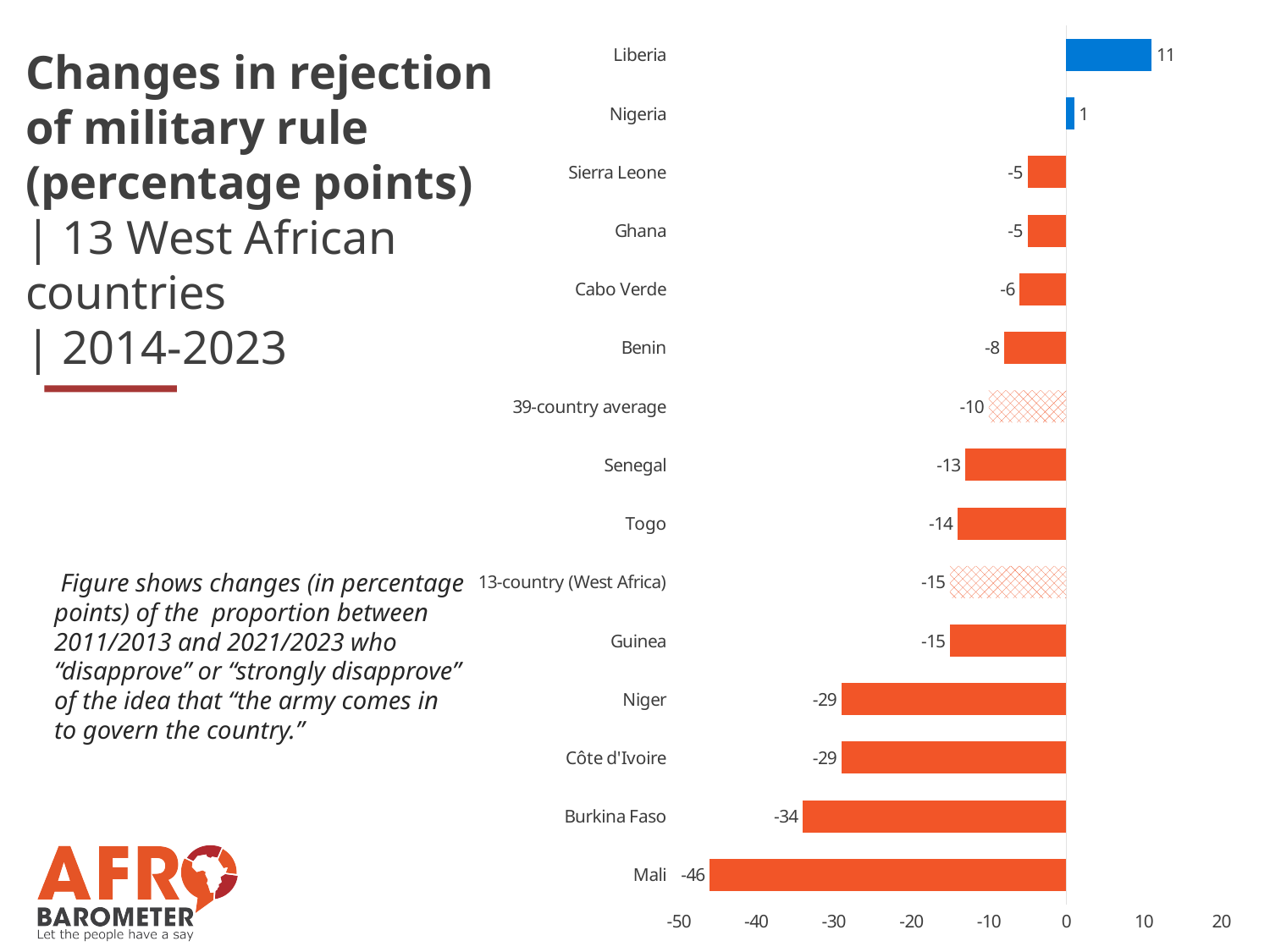
Is the value for Niger greater or less than -20? less Which country has the lowest value? Mali What is the value for the 13-country (West Africa) average? -15 What is the value for the 39-country average? -10 What is the difference between the values for Burkina Faso and Mali? 12 How many bars are plotted in the chart? 15 Which country has the highest value? Liberia Which has a larger value, Senegal or Togo? Senegal What is the value for Mali? -46 What kind of chart is shown on the slide? Bar chart What is the value for Liberia? 11 Which two countries both have a value of -29? Niger and Côte d'Ivoire